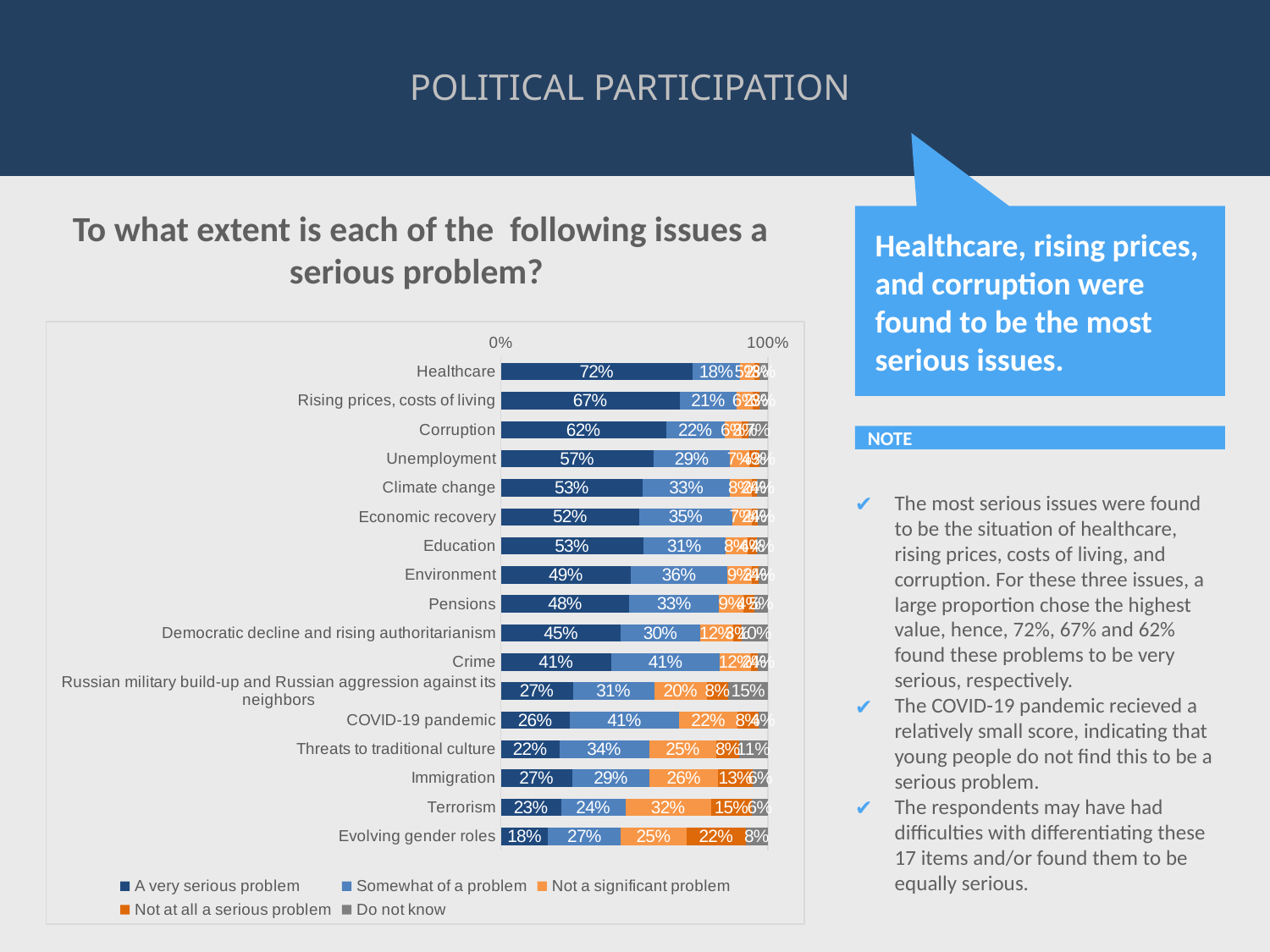
What is the difference between the 'A very serious problem' percentages for Healthcare and Corruption? 10% Which issue has the highest share of respondents saying it is a very serious problem? Healthcare Which issue has the lowest share of respondents saying it is a very serious problem? Evolving gender roles What percentage of respondents answered 'Do not know' for Russian military build-up and Russian aggression against its neighbors? 15% Which legend entry is shown in grey? Do not know Which has a larger 'A very serious problem' share: Unemployment or Climate change? Unemployment What kind of chart is shown on the slide? Stacked bar chart How many series does the legend list? 5 What percentage of respondents said Healthcare is a very serious problem? 72% What percentage of respondents said Terrorism is not a significant problem? 32% How many issues are listed in the chart? 17 What percentage of respondents said Crime is somewhat of a problem? 41%